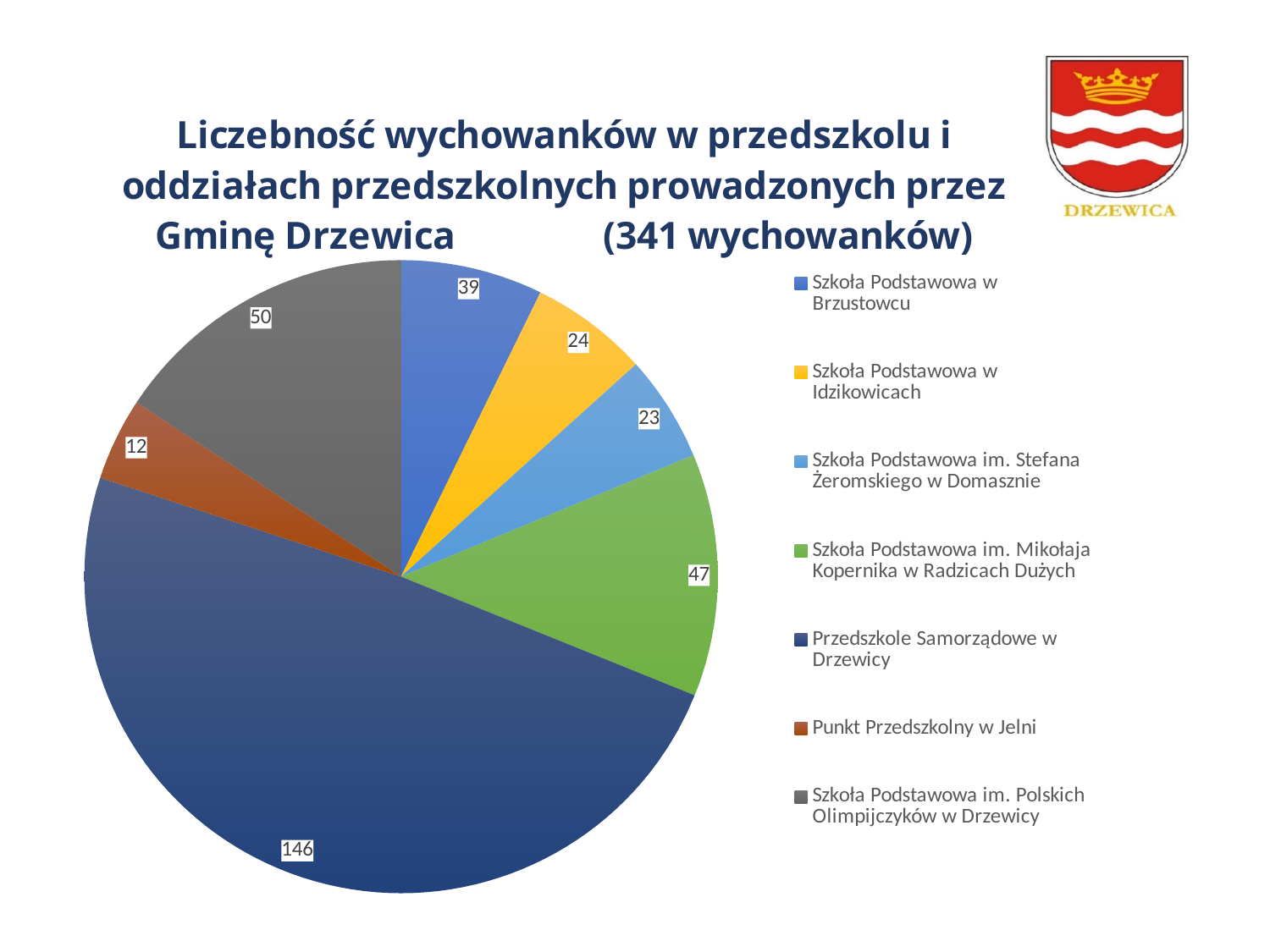
Which is larger: the value for Szkoła Podstawowa w Idzikowicach or for Szkoła Podstawowa im. Stefana Żeromskiego w Domasznie? Szkoła Podstawowa w Idzikowicach What total number of pupils is stated in the chart title? 341 wychowanków What is the value for Szkoła Podstawowa w Brzustowcu? 39 Which category has the largest slice of the pie? Przedszkole Samorządowe w Drzewicy What colour is the slice for Szkoła Podstawowa w Idzikowicach? yellow Which category has the smallest slice of the pie? Punkt Przedszkolny w Jelni How many slices does the pie chart have? 7 What is the difference between the values for Szkoła Podstawowa im. Mikołaja Kopernika w Radzicach Dużych and Szkoła Podstawowa w Brzustowcu? 8 What kind of chart is shown on the slide? pie chart What is the value for Szkoła Podstawowa im. Polskich Olimpijczyków w Drzewicy? 50 What is the value for Punkt Przedszkolny w Jelni? 12 How many pupils does the pie chart show for Przedszkole Samorządowe w Drzewicy? 146